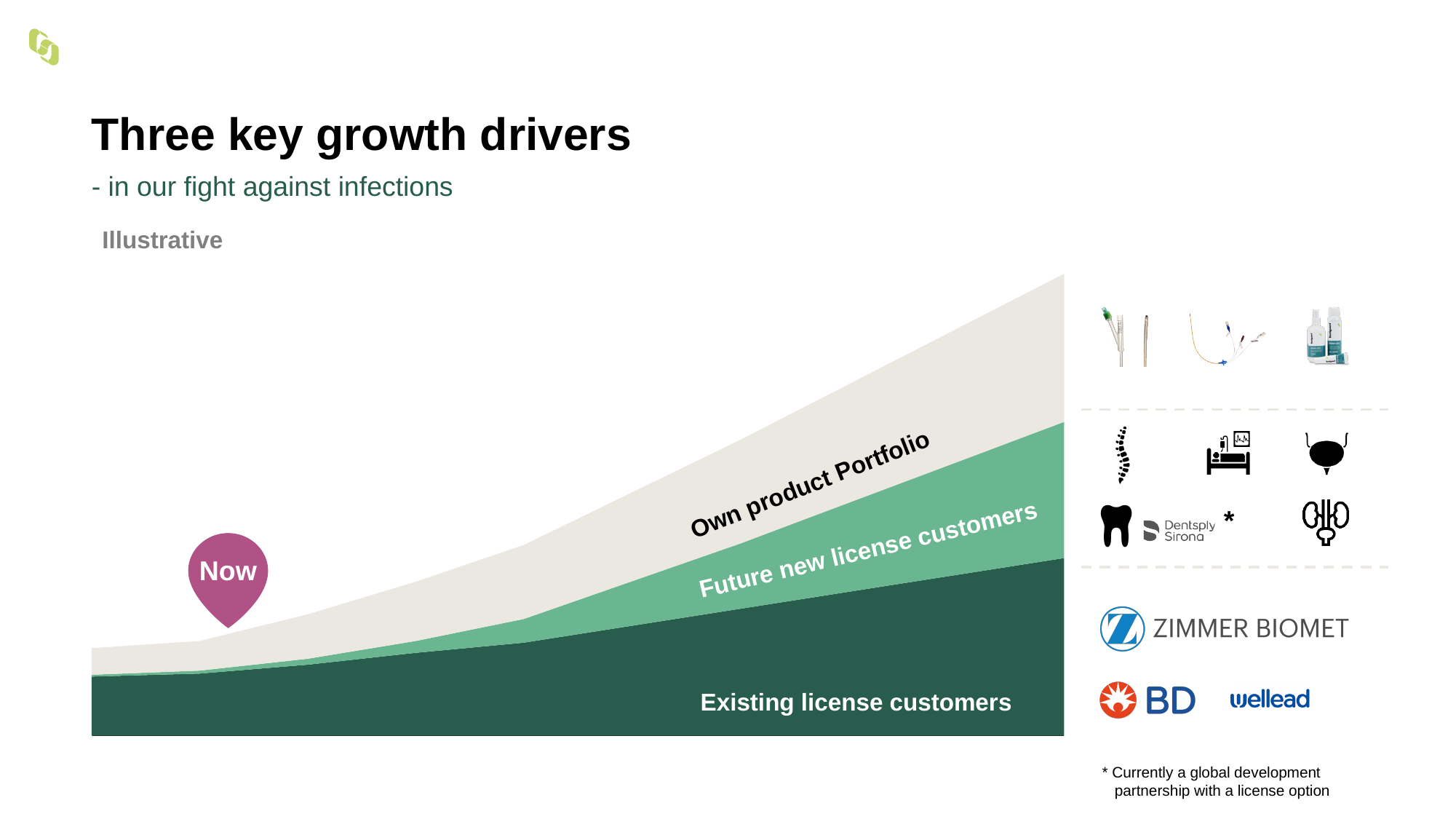
Which layer is the largest at the right edge of the chart? Existing license customers Does the total height of the stacked area rise or fall from left to right? Rise Which layer is in the middle of the stacked area chart? Future new license customers Does the 'Own product Portfolio' layer grow or shrink toward the right side of the chart? Grow What kind of chart is shown on the slide? Stacked area chart What label is shown on the marker placed on the chart? Now Which layer sits at the top of the stacked area chart? Own product Portfolio Which layer sits at the bottom of the stacked area chart? Existing license customers How many layers (growth drivers) are stacked in the chart? 3 At the 'Now' marker, which layer makes up almost all of the stacked area? Existing license customers What word above the chart indicates that the chart is not based on actual data? Illustrative